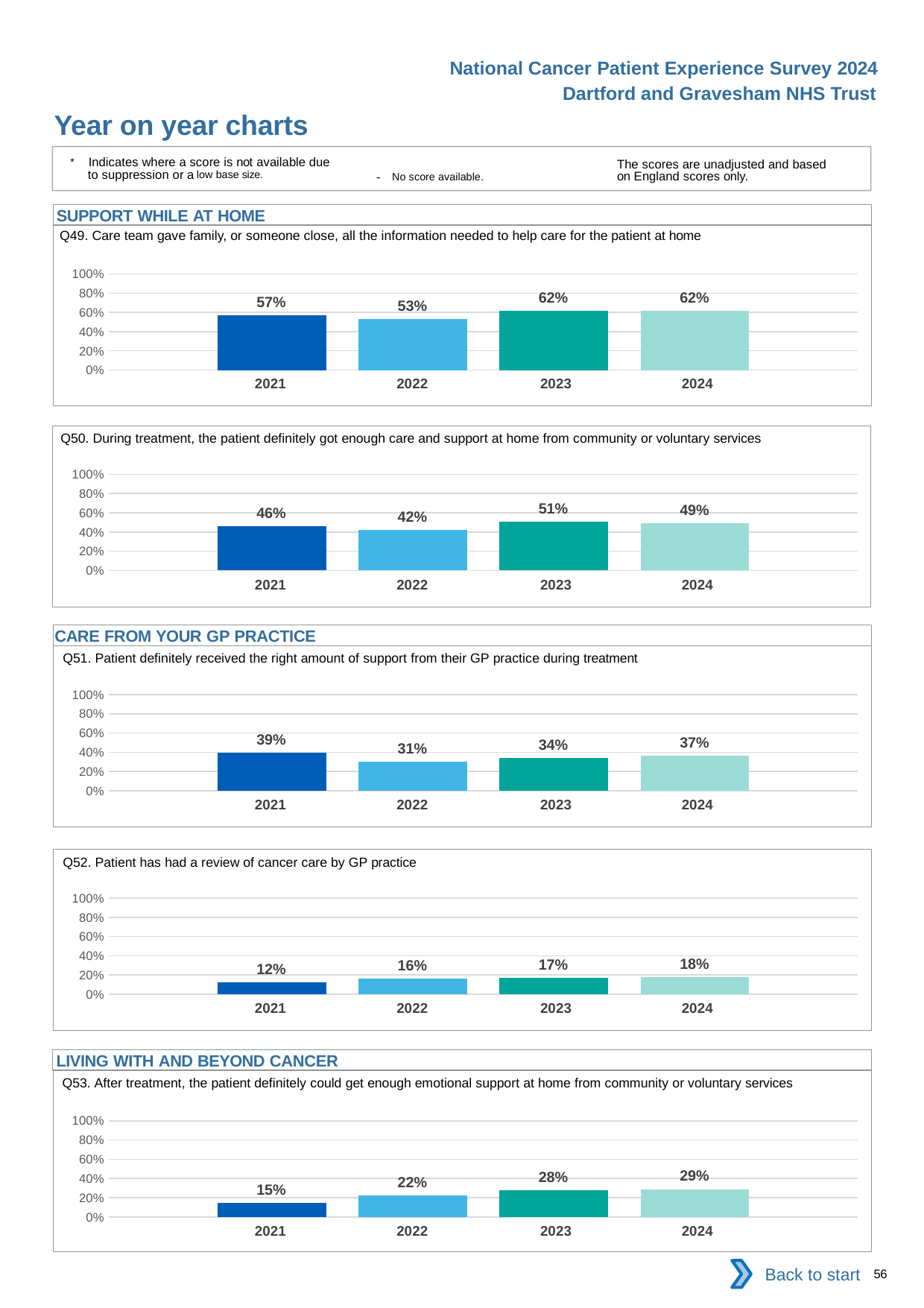
In the Q53 chart, is the value for 2021 larger or smaller than the value for 2024? smaller In the Q51 chart, which year has the lowest value? 2022 In the Q50 chart, which year has the highest value? 2023 In the Q49 chart, is the value for 2023 greater or less than 40%? greater How many years are plotted in the Q50 chart? 4 What kind of chart is the Q51 chart? bar chart In the Q50 chart, what is the difference between the 2023 value and the 2022 value? 9% Which section heading appears above the Q53 chart? LIVING WITH AND BEYOND CANCER In the Q49 chart, what is the value for 2022? 53% In the Q53 chart, what is the value for 2023? 28% In the Q52 chart, do the values rise or fall from 2021 to 2024? rise In the Q52 chart, what is the difference between the 2024 value and the 2021 value? 6%